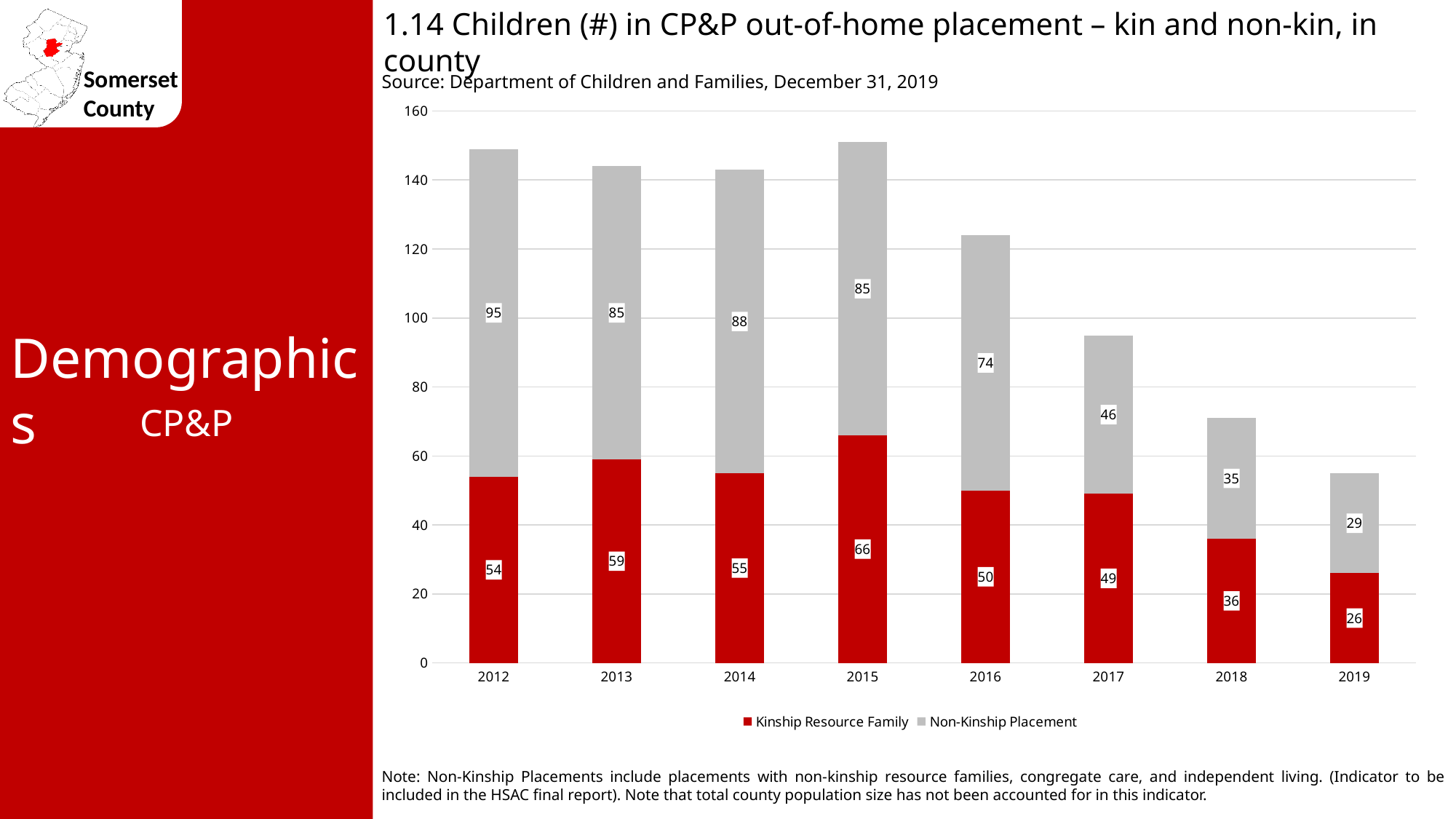
What is the total of the stacked bar for 2015? 151 What is the difference between the Non-Kinship Placement values for 2012 and 2019? 66 What is the Non-Kinship Placement value for 2019? 29 Which year has the lowest Non-Kinship Placement value? 2019 What is the Kinship Resource Family value for 2015? 66 What kind of chart is shown? Stacked bar chart What is the Non-Kinship Placement value for 2012? 95 How many years are shown on the x axis? 8 Which year has the highest Kinship Resource Family value? 2015 What is the total of the stacked bar for 2018? 71 How many series does the legend list? 2 Which is larger, the Kinship Resource Family value for 2013 or for 2014? 2013